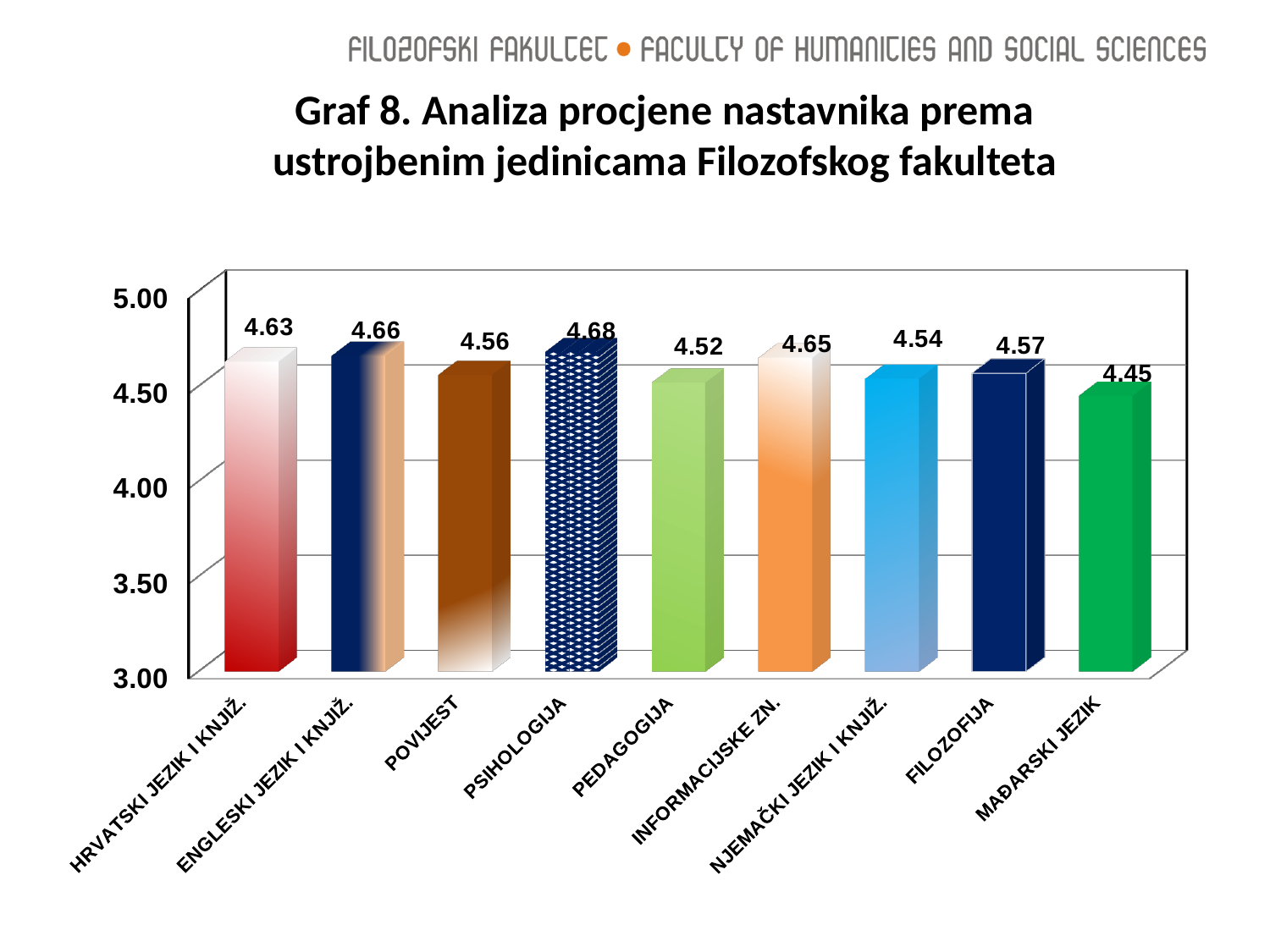
What is the value for POVIJEST? 4.56 What is the value for MAĐARSKI JEZIK? 4.45 Which is larger, the value for HRVATSKI JEZIK I KNJIŽ. or the value for FILOZOFIJA? HRVATSKI JEZIK I KNJIŽ. What is the title of the chart? Graf 8. Analiza procjene nastavnika prema ustrojbenim jedinicama Filozofskog fakulteta What is the difference between the values for PSIHOLOGIJA and MAĐARSKI JEZIK? 0.23 What kind of chart is shown on the slide? bar chart Which category has the lowest value? MAĐARSKI JEZIK How many categories are shown in the chart? 9 What is the value for PEDAGOGIJA? 4.52 Which category has the highest value? PSIHOLOGIJA What is the difference between the values for ENGLESKI JEZIK I KNJIŽ. and POVIJEST? 0.10 Is the value for NJEMAČKI JEZIK I KNJIŽ. greater or less than 4.00? greater